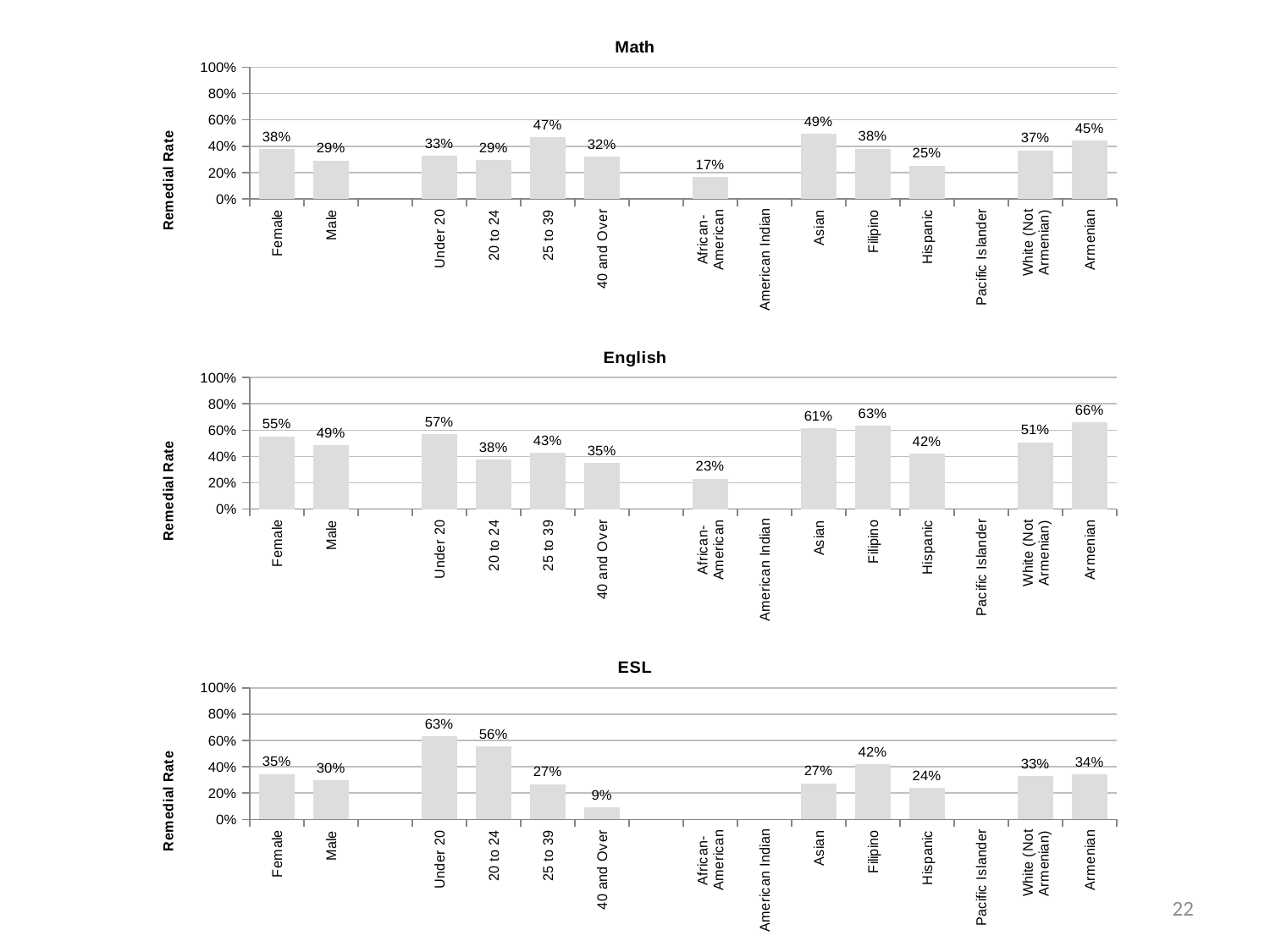
In the Math chart, which category has the highest remedial rate? Asian What is the y-axis label on the English chart? Remedial Rate In the ESL chart, which category has the highest remedial rate? Under 20 In the English chart, what is the remedial rate for Hispanic students? 42% In the English chart, what is the difference between the remedial rates for Armenian and White (Not Armenian)? 15% In the Math chart, what is the difference between the remedial rates for 25 to 39 and 20 to 24? 18% In the ESL chart, is the remedial rate for 20 to 24 greater or less than 40%? greater In the English chart, which has a higher remedial rate, Filipino or Asian? Filipino What type of chart is the Math chart? Bar chart In the English chart, which category has the lowest remedial rate? African-American In the Math chart, what is the remedial rate for Female students? 38% In the ESL chart, what is the remedial rate for the 40 and Over group? 9%